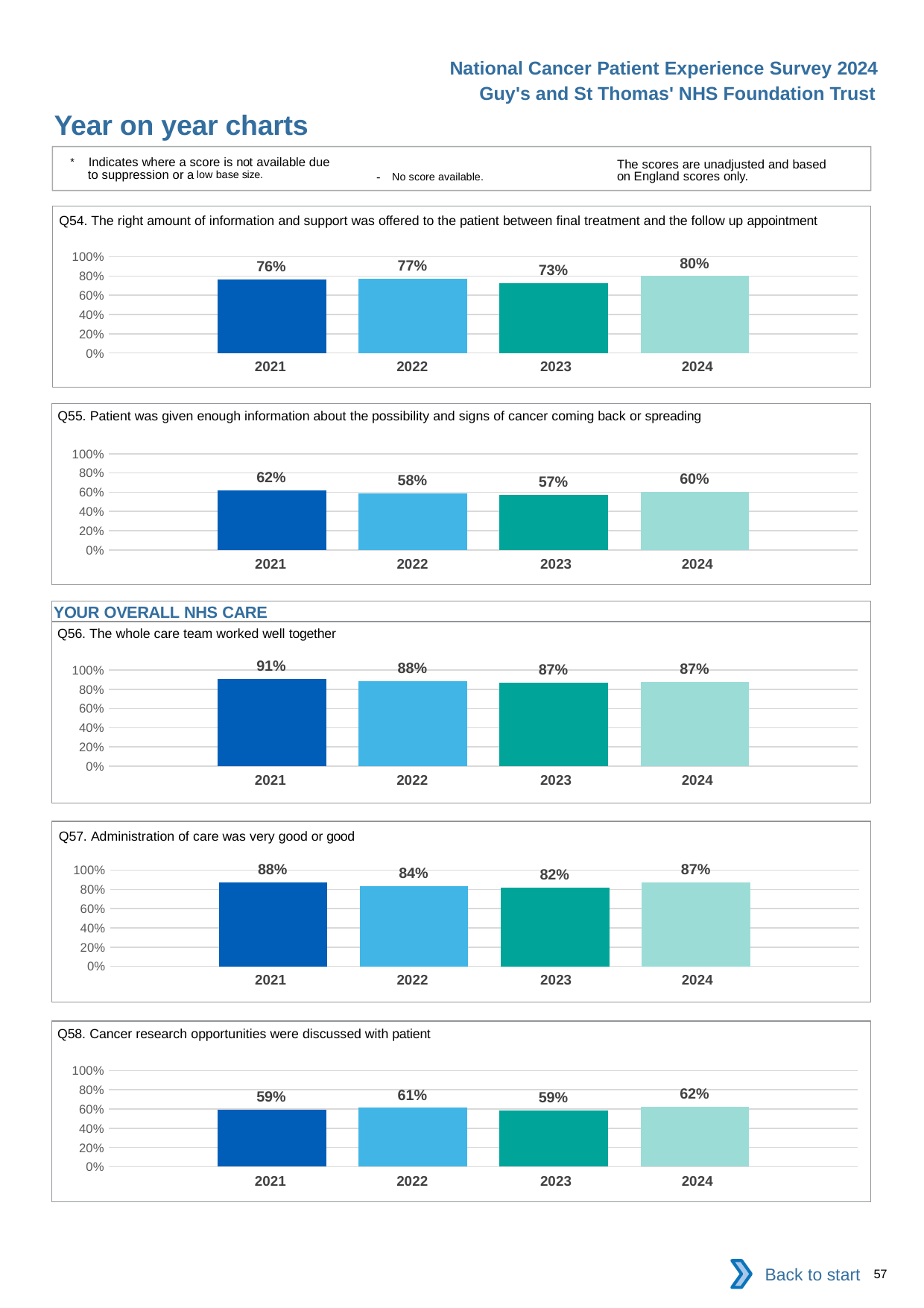
In the Q54 chart, which year has the lowest value? 2023 In the Q57 chart, what is the difference between the 2021 and 2023 values? 6% How many bars are in the Q58 chart? 4 In the Q55 chart, what is the difference between the 2021 and 2023 values? 5% In the Q57 chart, which is larger, the value for 2022 or the value for 2024? 2024 In the Q56 chart, do the values rise or fall from 2021 to 2023? Fall What kind of chart is the Q57 chart? Bar chart In the Q58 chart, what is the value for 2024? 62% In the Q56 chart, what is the value for 2023? 87% In the Q56 chart, which year has the highest value? 2021 In the Q55 chart, what is the value for 2022? 58% In the Q54 chart, what is the value for 2024? 80%